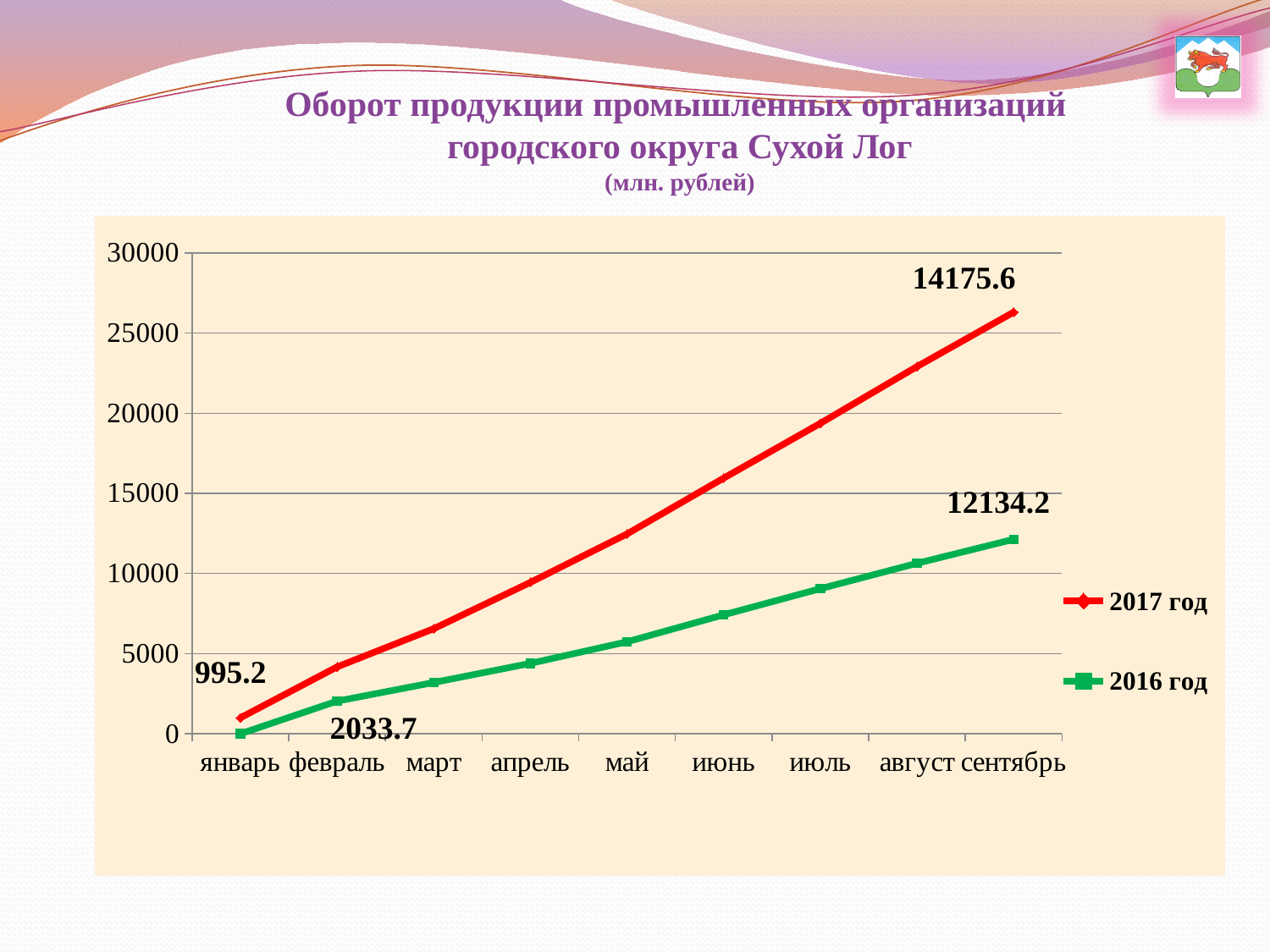
What is the data label shown for January on the 2017 год series? 995.2 What type of chart is shown on the slide? line chart How many months are shown along the x axis? 9 How many series does the legend list? 2 What is the data label shown for September on the 2016 год series? 12134.2 What is the data label shown for February on the 2016 год series? 2033.7 Which colour is used for the 2017 год series? red Is the value for May on the 2016 год series greater or less than 10000? less Which series has the higher value in September, 2017 год or 2016 год? 2017 год Do the values of the 2016 год series rise or fall from January to September? rise